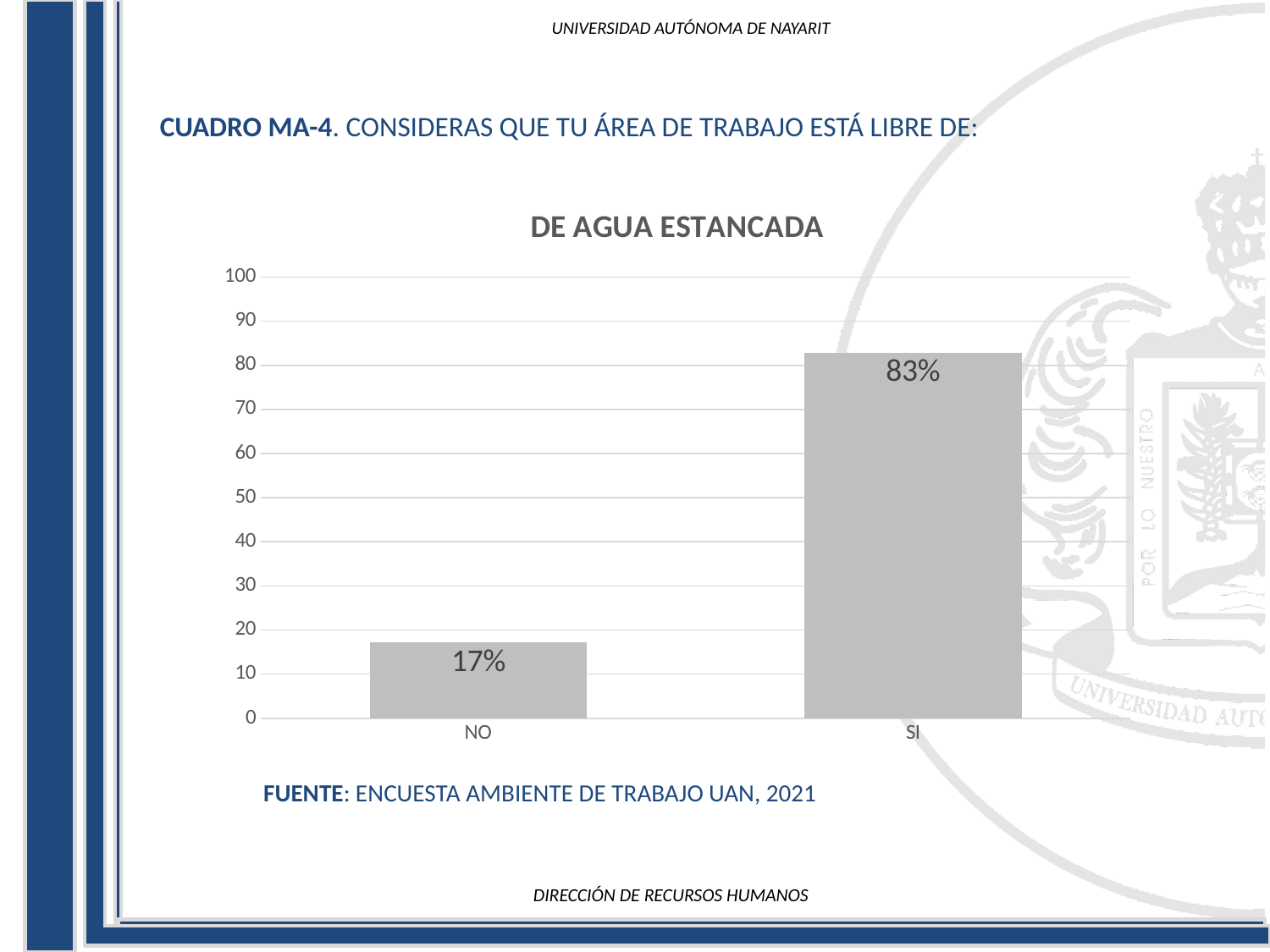
What is the maximum value shown on the y axis? 100 Is the value for SI greater or less than 80? greater Which is larger, the value for NO or the value for SI? SI How many categories are shown on the x axis? 2 What kind of chart is shown on the slide? bar chart Is the value for NO greater or less than 20? less What is the value for NO? 17% What is the difference between the values for SI and NO? 66% What is the title of the chart? DE AGUA ESTANCADA Which category has the lowest value? NO Which category has the highest value? SI What is the value for SI? 83%